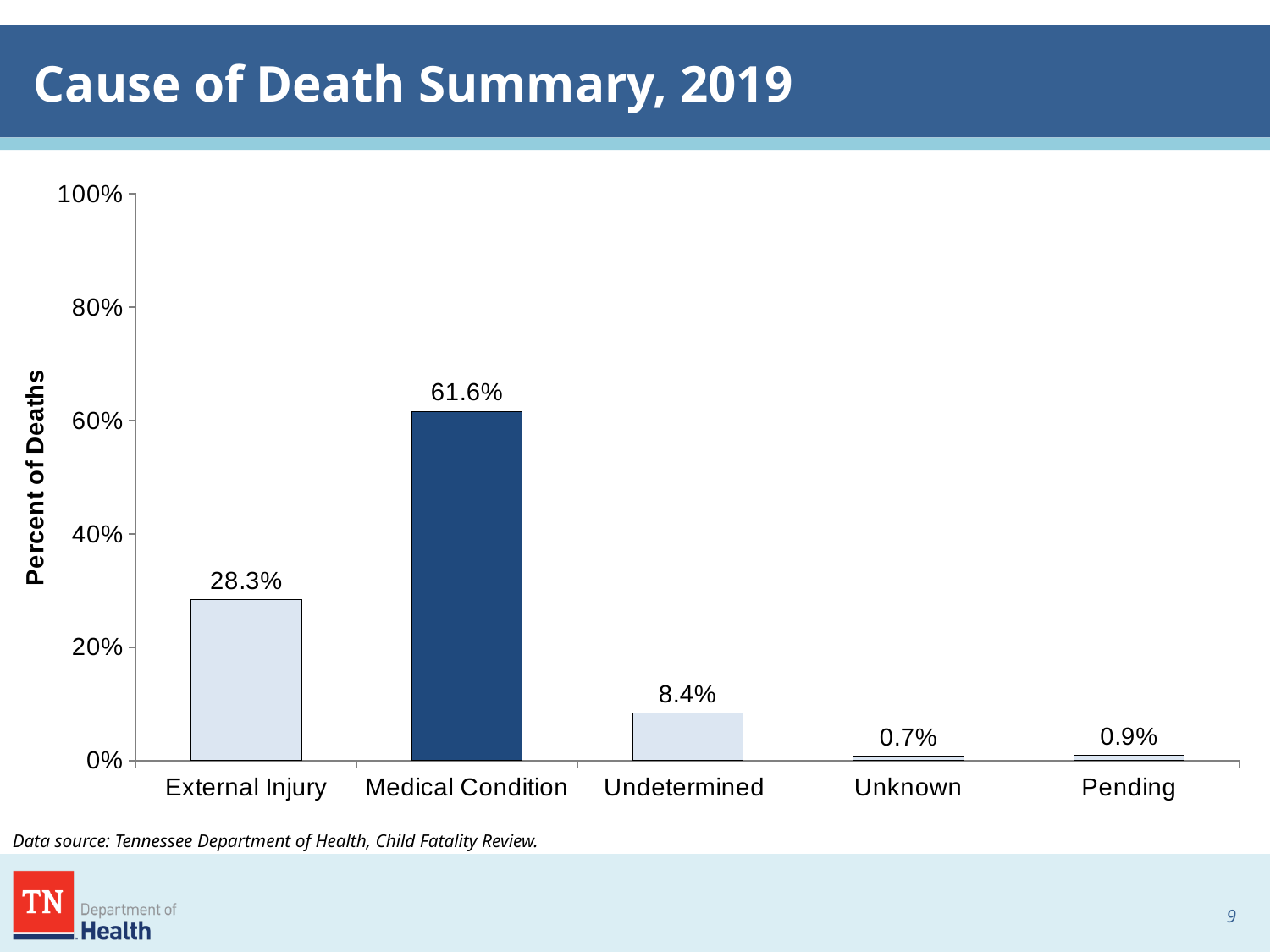
What percent of deaths were due to External Injury? 28.3% What percent of deaths were Pending? 0.9% What kind of chart is shown on the slide? Bar chart Which cause of death category has the highest percent of deaths? Medical Condition What is the difference in percentage points between Medical Condition and External Injury? 33.3 Which cause of death category has the lowest percent of deaths? Unknown What percent of deaths were due to Medical Condition? 61.6% What is the label of the y axis? Percent of Deaths Which is larger, the percent for Undetermined or the percent for Pending? Undetermined Is the value for External Injury greater or less than 40%? less How many cause of death categories are shown on the chart? 5 What percent of deaths were Undetermined? 8.4%